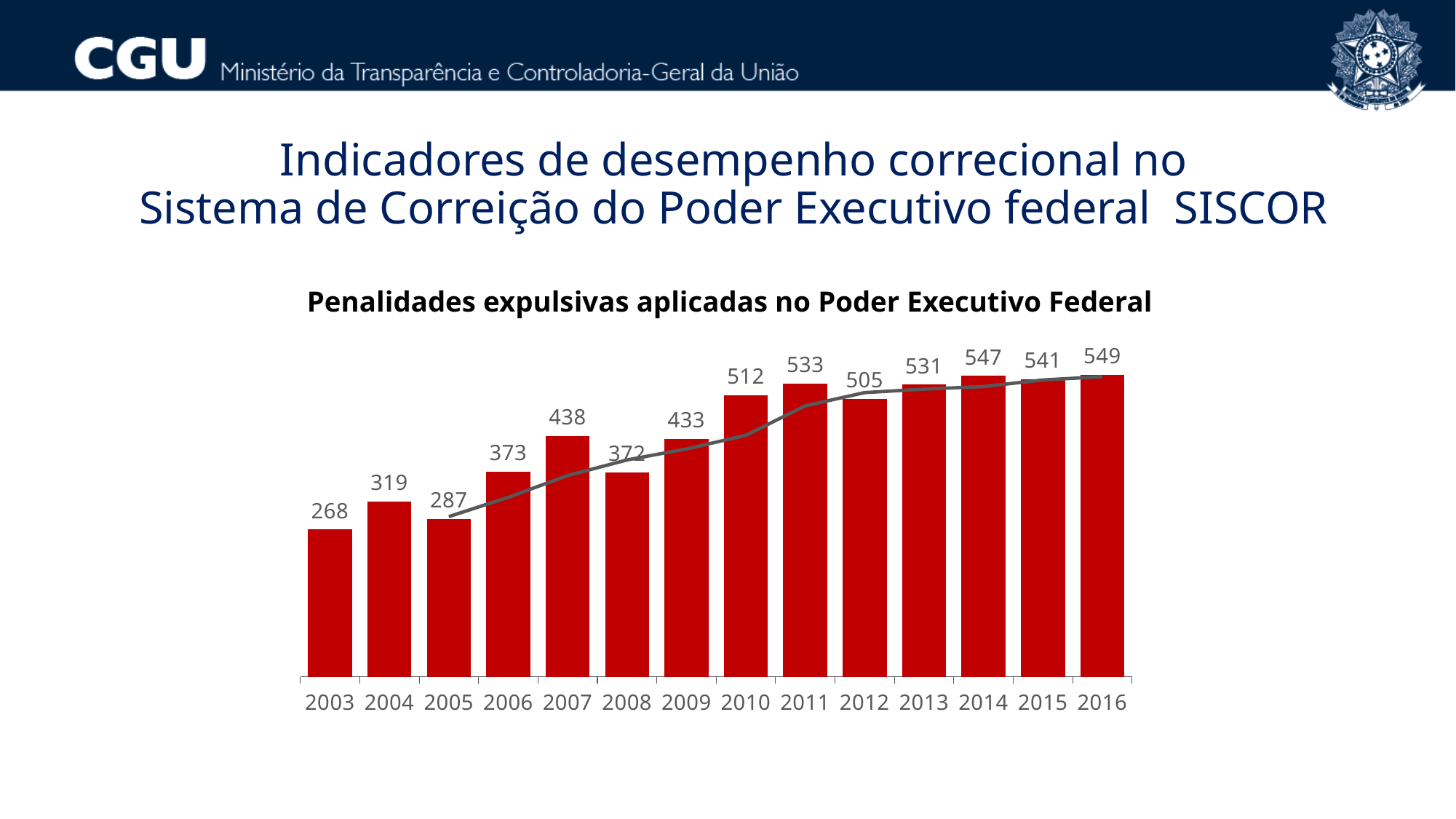
Which is larger, the value for 2007 or the value for 2008? 2007 What is the value for 2010? 512 What is the difference between the values for 2016 and 2003? 281 What kind of chart is this? bar chart What is the value for 2014? 547 What is the difference between the values for 2011 and 2012? 28 How many years are shown on the x axis? 14 Do the values generally rise or fall from 2003 to 2016? rise Which year has the highest value? 2016 What is the title of the chart? Penalidades expulsivas aplicadas no Poder Executivo Federal What is the value for 2003? 268 Which year has the lowest value? 2003